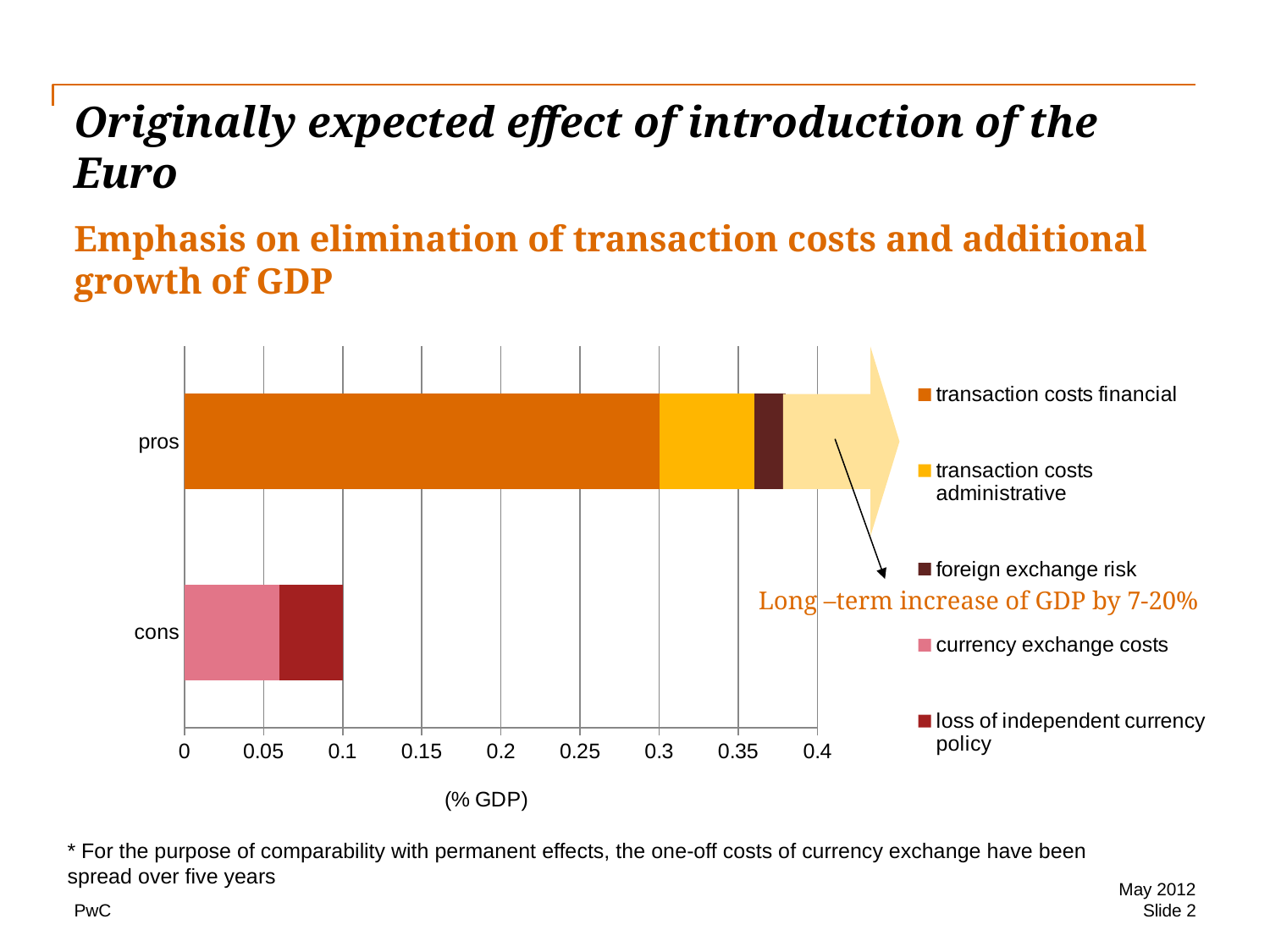
Which category has the shortest total bar? cons At what value on the x axis does the 'transaction costs financial' segment of the pros bar end? 0.3 Is the total value of the pros bar greater or less than 0.35? greater Which category has the longest total bar? pros Is the total value of the cons bar greater or less than 0.15? less What is the total length of the cons bar, as read from the x axis? 0.1 Is the 'currency exchange costs' segment of the cons bar greater or less than 0.1? less How many series does the chart's legend list? 5 Which category has the longer total bar, pros or cons? pros What is the title of the chart's x axis? (% GDP) What kind of chart is shown on the slide? stacked bar chart How many categories are plotted on the vertical axis of the chart? 2